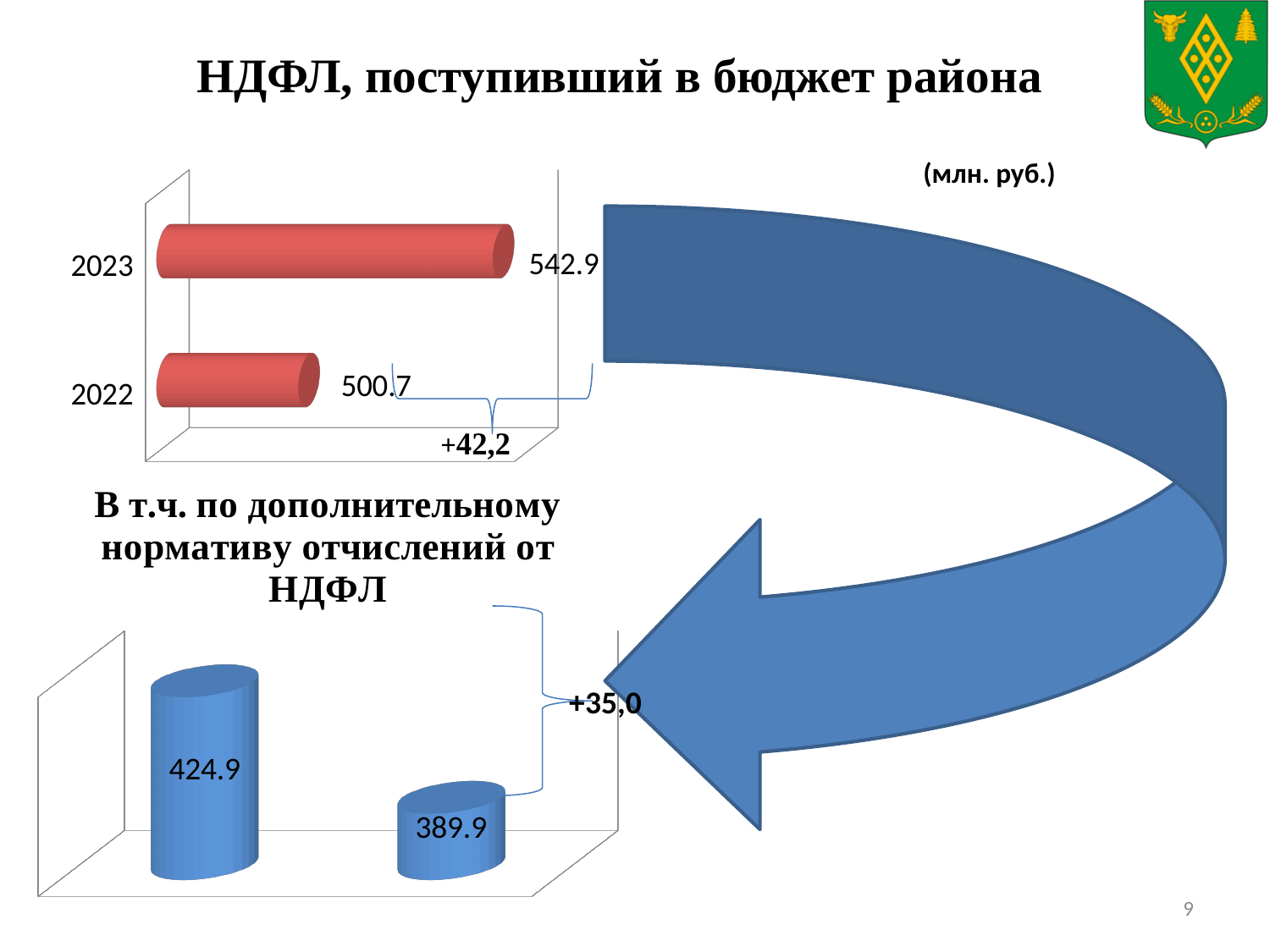
In the top chart, which year has the higher value? 2023 What kind of chart is the top chart? bar chart In the top chart, is the value for 2022 larger or smaller than the value for 2023? smaller In the top chart, what is the value for 2022? 500.7 In the top chart, what is the value for 2023? 542.9 What unit is indicated for the values on the slide? млн. руб. In the top chart, which year has the lower value? 2022 In the bottom chart, what is the value of the shorter bar? 389.9 In the bottom chart, what is the value of the taller bar? 424.9 In the top chart, what is the difference between the 2023 and 2022 values? 42.2 How many categories does the top chart show? 2 In the bottom chart, what is the difference between the two bar values? 35.0